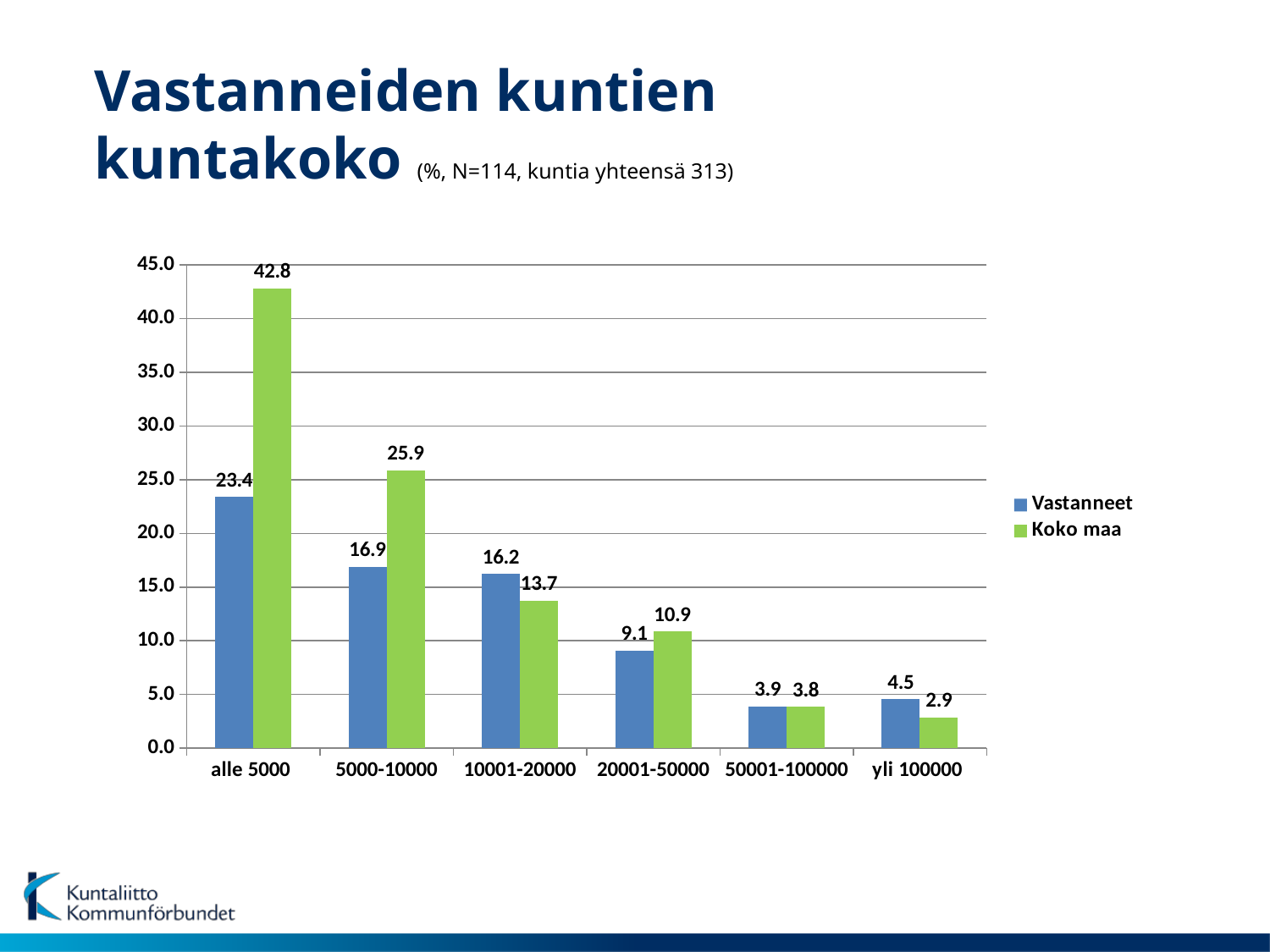
How many categories are shown on the x axis? 6 Which category has the lowest Vastanneet value? 50001-100000 Which colour represents the Koko maa series? green Is the Koko maa value for '20001-50000' greater or less than 10.0? greater What is the Koko maa value for the 'yli 100000' category? 2.9 How many series does the legend list? 2 What kind of chart is shown on the slide? bar chart For the '10001-20000' category, which series has the larger value, Vastanneet or Koko maa? Vastanneet What is the difference between the Koko maa and Vastanneet values for 'alle 5000'? 19.4 What is the Vastanneet value for the 'alle 5000' category? 23.4 Which category has the highest Koko maa value? alle 5000 What is the Koko maa value for the '5000-10000' category? 25.9